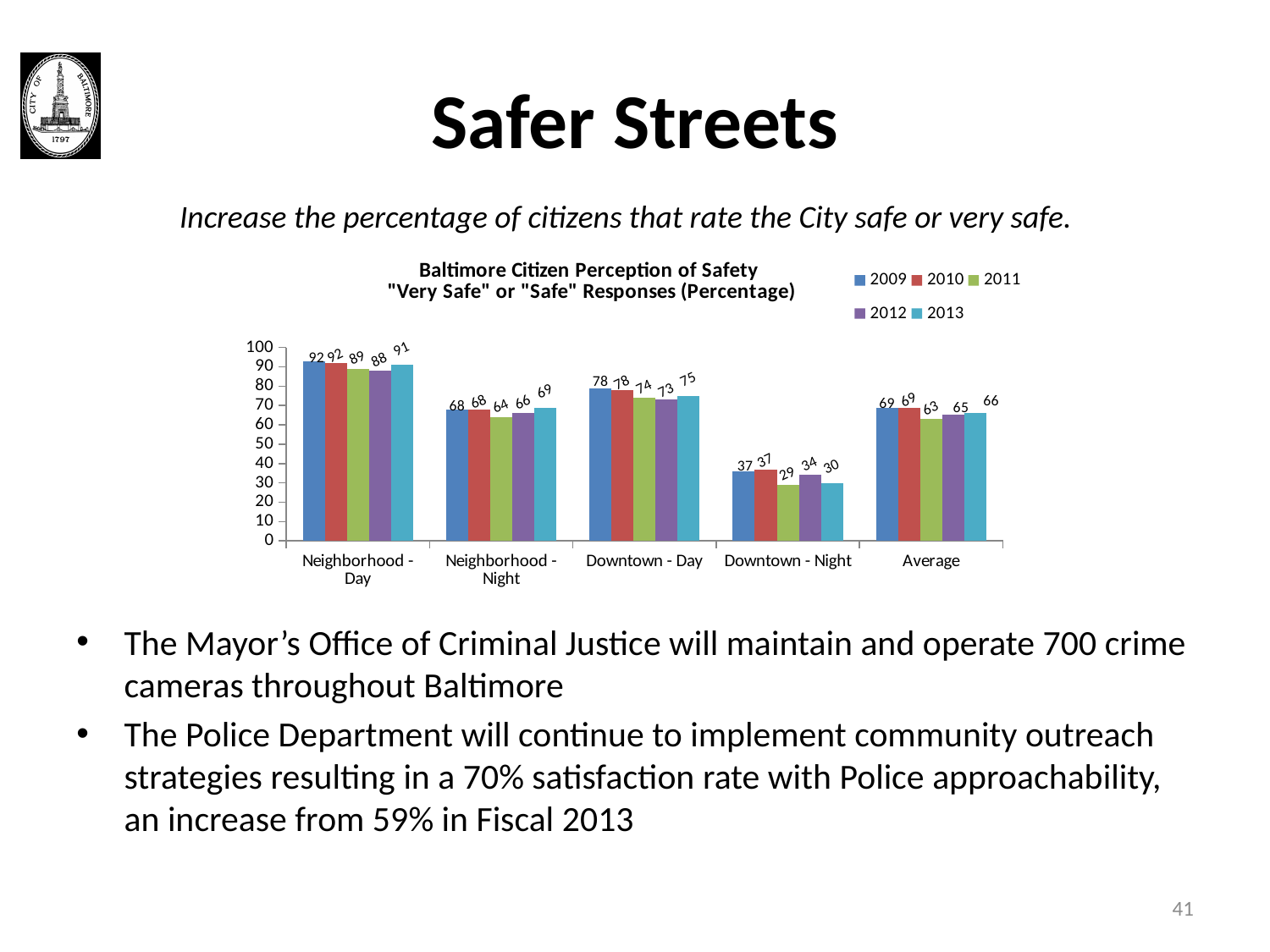
Which category has the lowest 2009 value? Downtown - Night How many series does the legend list? 5 What is the difference between the 2009 and 2011 values for Downtown - Night? 8 What is the 2013 value for Neighborhood - Day? 91 Which is larger, the 2012 value for Neighborhood - Night or the 2012 value for Downtown - Day? Downtown - Day What is the 2012 value for Average? 65 What is the 2011 value for Downtown - Night? 29 What is the title of the chart? Baltimore Citizen Perception of Safety "Very Safe" or "Safe" Responses (Percentage) How many categories are shown on the x axis? 5 Which category has the highest 2013 value? Neighborhood - Day What kind of chart is shown? bar chart Is the 2010 value for Downtown - Night greater or less than 40? less